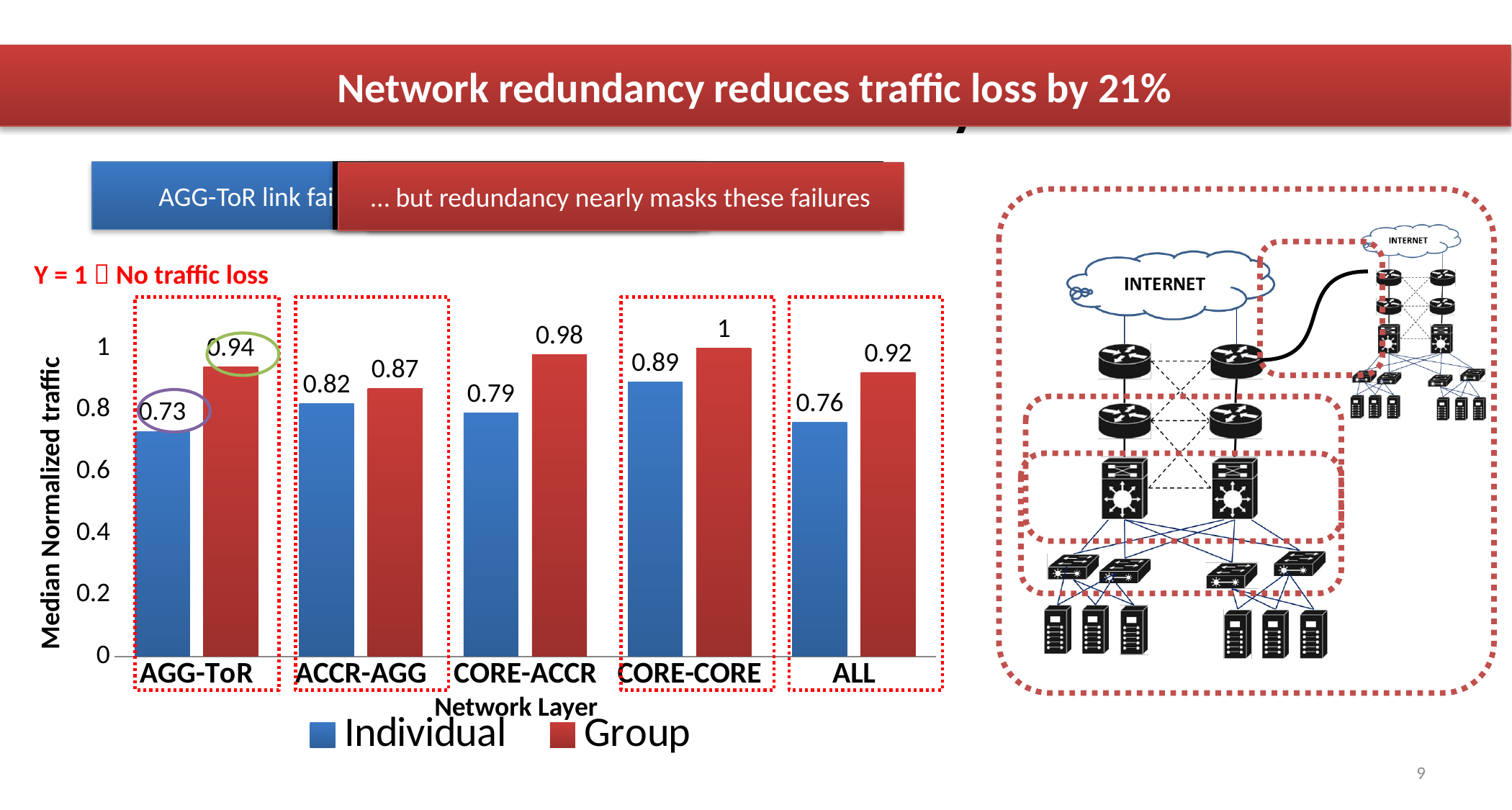
What is the Group value for CORE-ACCR? 0.98 Which network layer has the lowest Individual value? AGG-ToR Which network layer has the highest Group value? CORE-CORE What kind of chart is shown on the slide? bar chart What is the Individual value for AGG-ToR? 0.73 How many series does the legend list? 2 What is the Group value for ALL? 0.92 How many network layer categories are shown on the x axis? 5 Which is larger for ACCR-AGG, the Individual value or the Group value? Group What is the difference between the Group and Individual values for AGG-ToR? 0.21 What is the Individual value for CORE-CORE? 0.89 Is the Individual value for ALL greater or less than 0.8? less